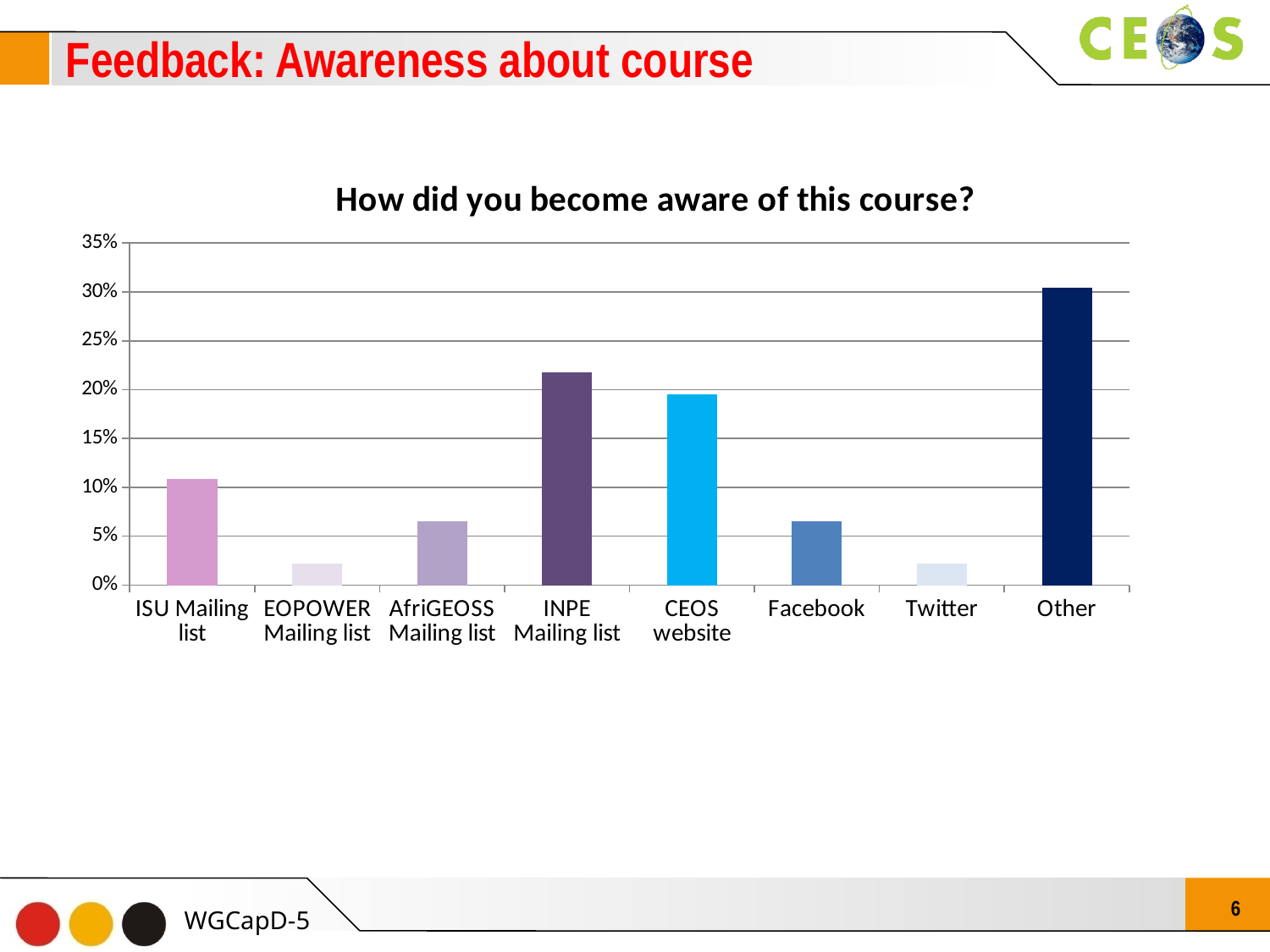
What is the title of the chart? How did you become aware of this course? Is the value for Other greater or less than 25%? greater Is the value for Facebook greater or less than 10%? less Is the value for CEOS website greater or less than 15%? greater How many categories are shown on the x axis of the chart? 8 Which category has the highest value? Other Which is larger, the value for INPE Mailing list or the value for CEOS website? INPE Mailing list What kind of chart is shown on the slide? bar chart Which is larger, the value for ISU Mailing list or the value for Facebook? ISU Mailing list